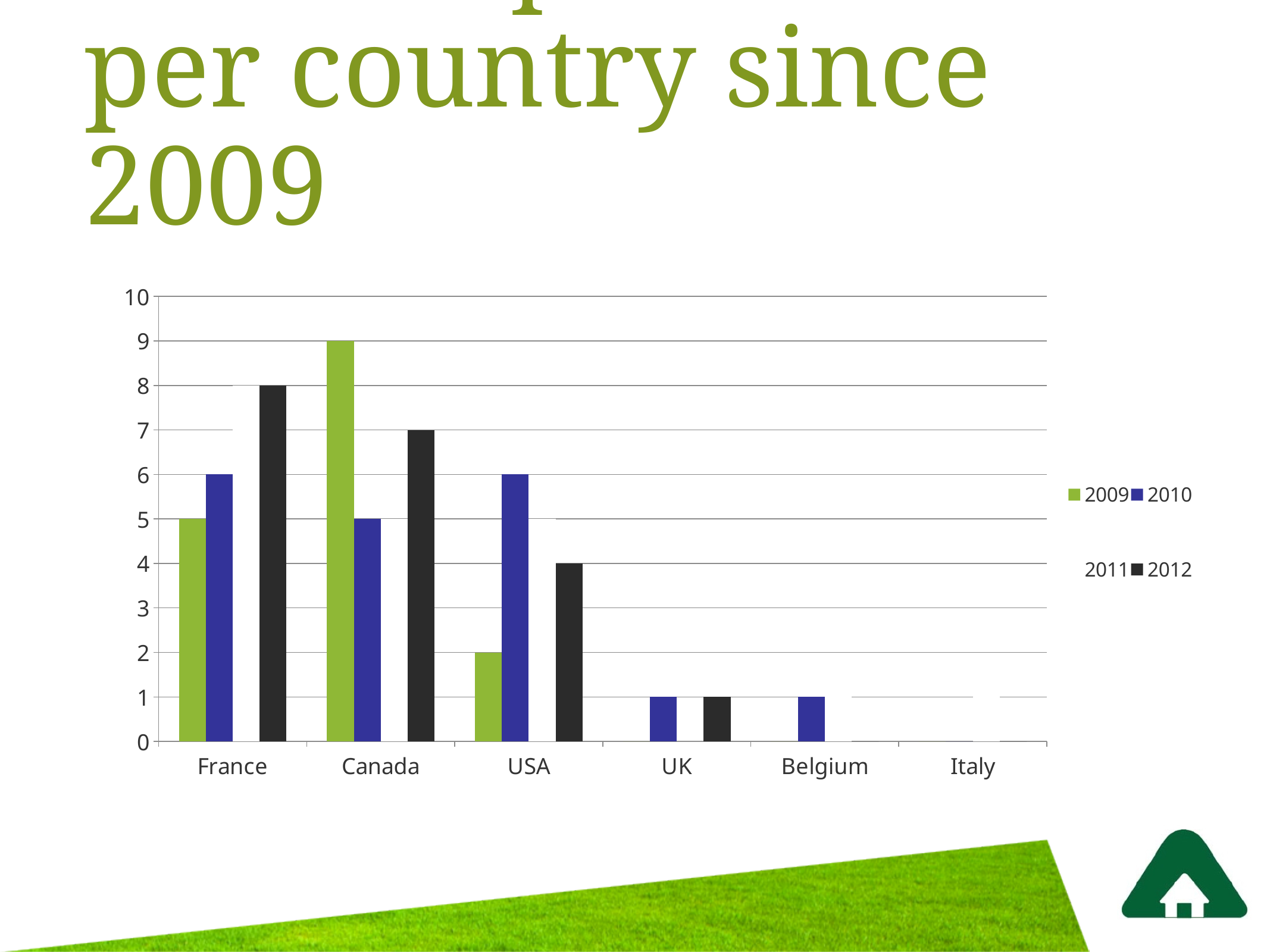
How many series does the legend list? 4 Which is larger, the 2012 value for Canada or the 2012 value for USA? Canada What kind of chart is shown on the slide? Bar chart What is the value for USA in 2010? 6 How many countries are shown on the x axis? 6 Which country has the highest value in 2012? France What is the value for France in 2009? 5 Which country has the highest value in 2009? Canada Which colour represents the 2012 series in the legend? Black What is the value for France in 2012? 8 What is the difference between the 2009 values for Canada and USA? 7 What is the value for Canada in 2009? 9